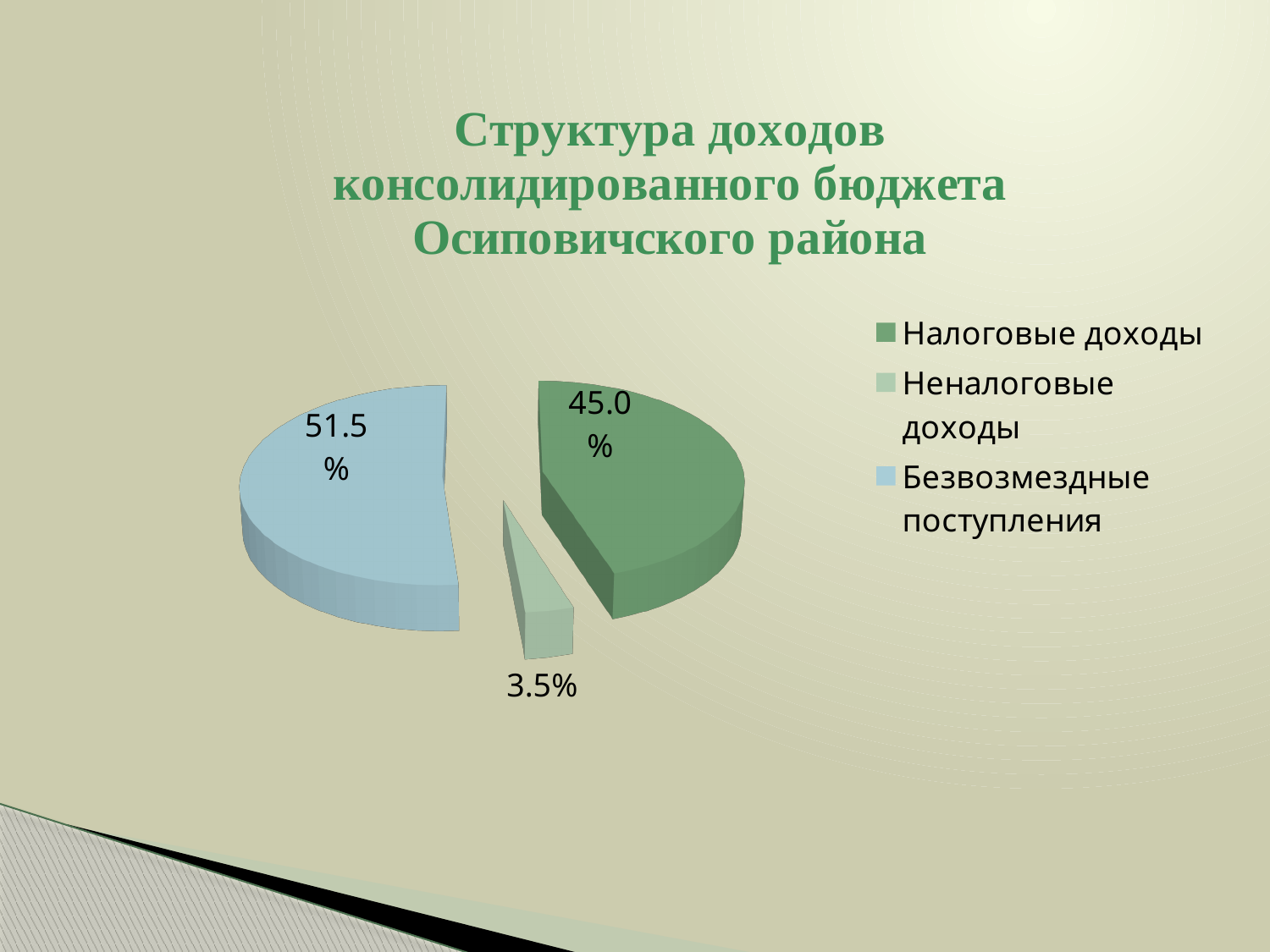
What is the difference between the shares of Безвозмездные поступления and Налоговые доходы? 6.5% How many entries does the legend list? 3 How many slices does the pie chart have? 3 What is the difference between the shares of Налоговые доходы and Неналоговые доходы? 41.5% What kind of chart is shown on the slide? pie chart What share of the pie is labelled for Налоговые доходы? 45.0% Which is larger: the share of Налоговые доходы or the share of Безвозмездные поступления? Безвозмездные поступления What share of the pie is labelled for Неналоговые доходы? 3.5% Which category has the largest share of the pie? Безвозмездные поступления Which category has the smallest share of the pie? Неналоговые доходы What share of the pie is labelled for Безвозмездные поступления? 51.5% What colour is the slice for Безвозмездные поступления? light blue